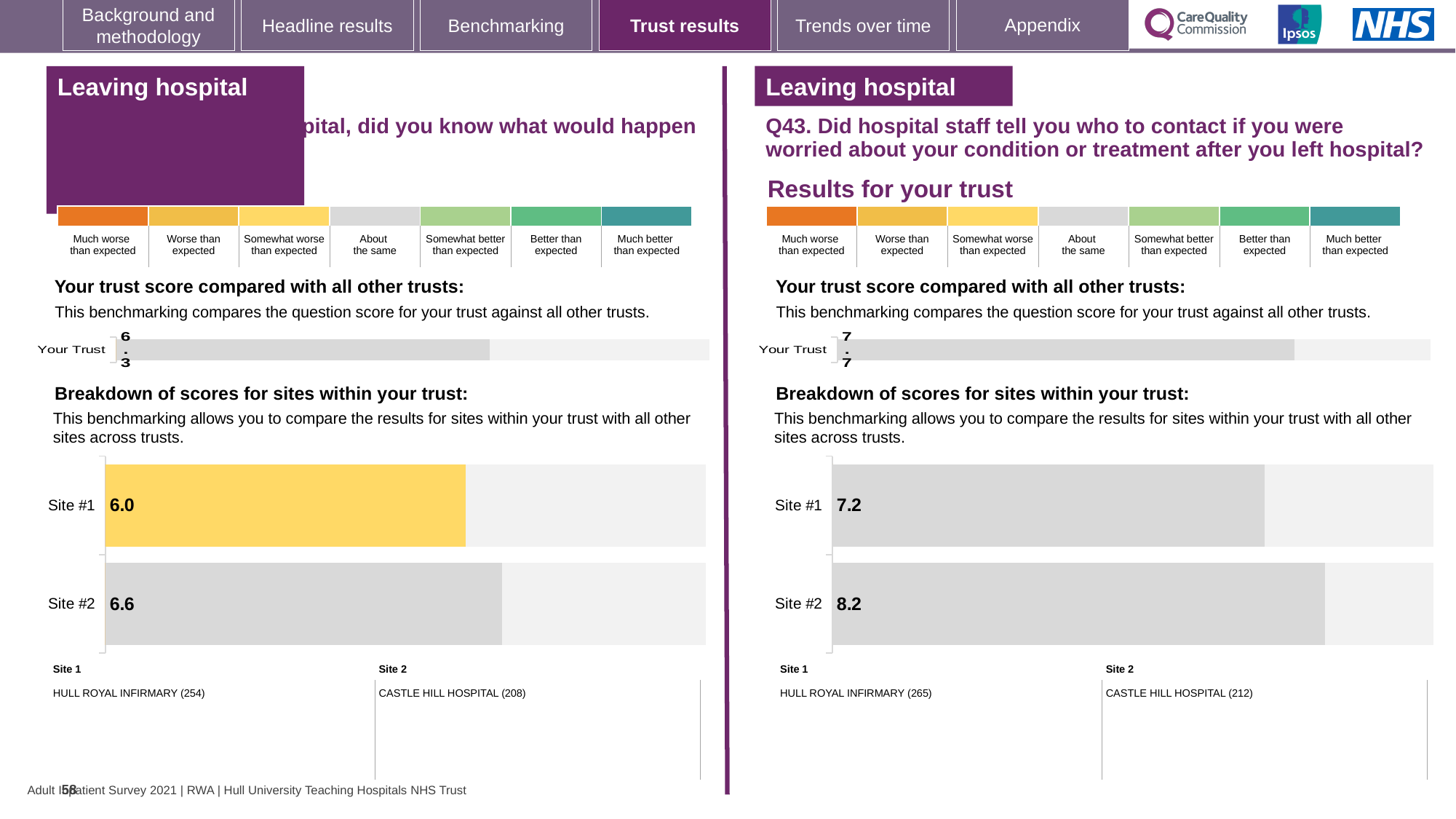
On the left half of the slide, what is the 'Your Trust' score shown in the 'Your trust score compared with all other trusts' chart? 6.3 On the right half of the slide (Q43), in the site breakdown chart, which site has the lower score? Site #1 On the left half of the slide, in the site breakdown chart, what is the difference between the Site #2 and Site #1 scores? 0.6 On the left half of the slide, in the 'Breakdown of scores for sites within your trust' chart, what is the score for Site #2? 6.6 On the right half of the slide (Q43), in the 'Breakdown of scores for sites within your trust' chart, what is the score for Site #2? 8.2 On the left half of the slide, in the 'Breakdown of scores for sites within your trust' chart, what is the score for Site #1? 6.0 On the right half of the slide (Q43), in the site breakdown chart, what is the difference between the Site #2 and Site #1 scores? 1.0 On the right half of the slide (Q43), in the 'Breakdown of scores for sites within your trust' chart, what is the score for Site #1? 7.2 On the right half of the slide (Q43), what is the 'Your Trust' score shown in the 'Your trust score compared with all other trusts' chart? 7.7 How many sites are shown in the site breakdown chart on the right half of the slide (Q43)? 2 On the left half of the slide, in the site breakdown chart, which site has the higher score? Site #2 What type of chart is used for the site breakdown on the left half of the slide? Bar chart